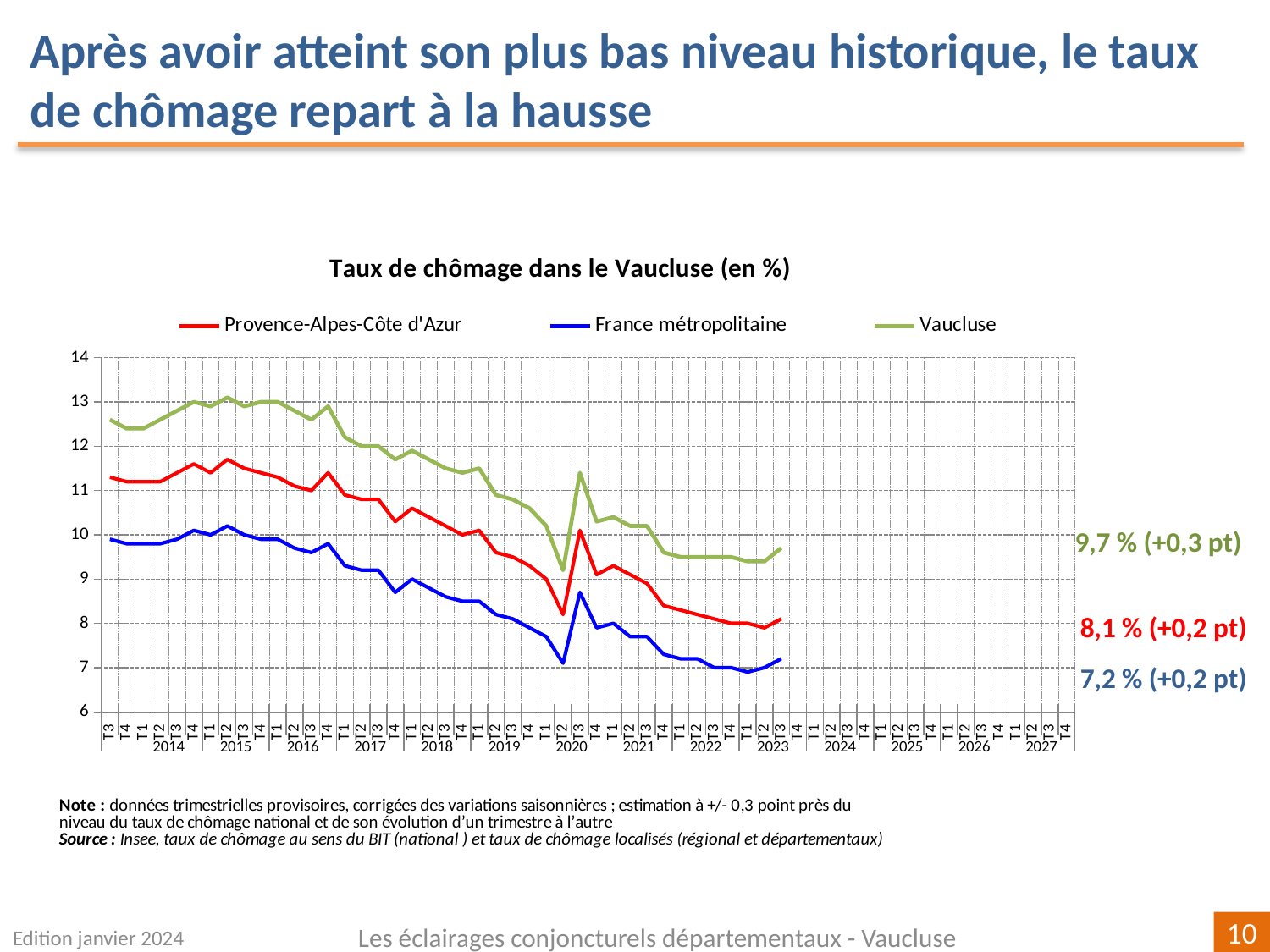
Which series has the lowest latest value? France métropolitaine Which series is drawn in green? Vaucluse Is the value for Vaucluse in T2 2015 greater or less than 12? greater Overall, do the unemployment rates rise or fall between 2014 and 2023? Fall What is the latest value labelled for Vaucluse? 9,7 % What kind of chart is shown on the slide? Line chart Which series has the highest latest value? Vaucluse How many series does the legend list? 3 What is the title of the chart? Taux de chômage dans le Vaucluse (en %) What is the latest value labelled for France métropolitaine? 7,2 % What is the latest value labelled for Provence-Alpes-Côte d'Azur? 8,1 % What is the difference between the latest values for Vaucluse and Provence-Alpes-Côte d'Azur? 1,6 points